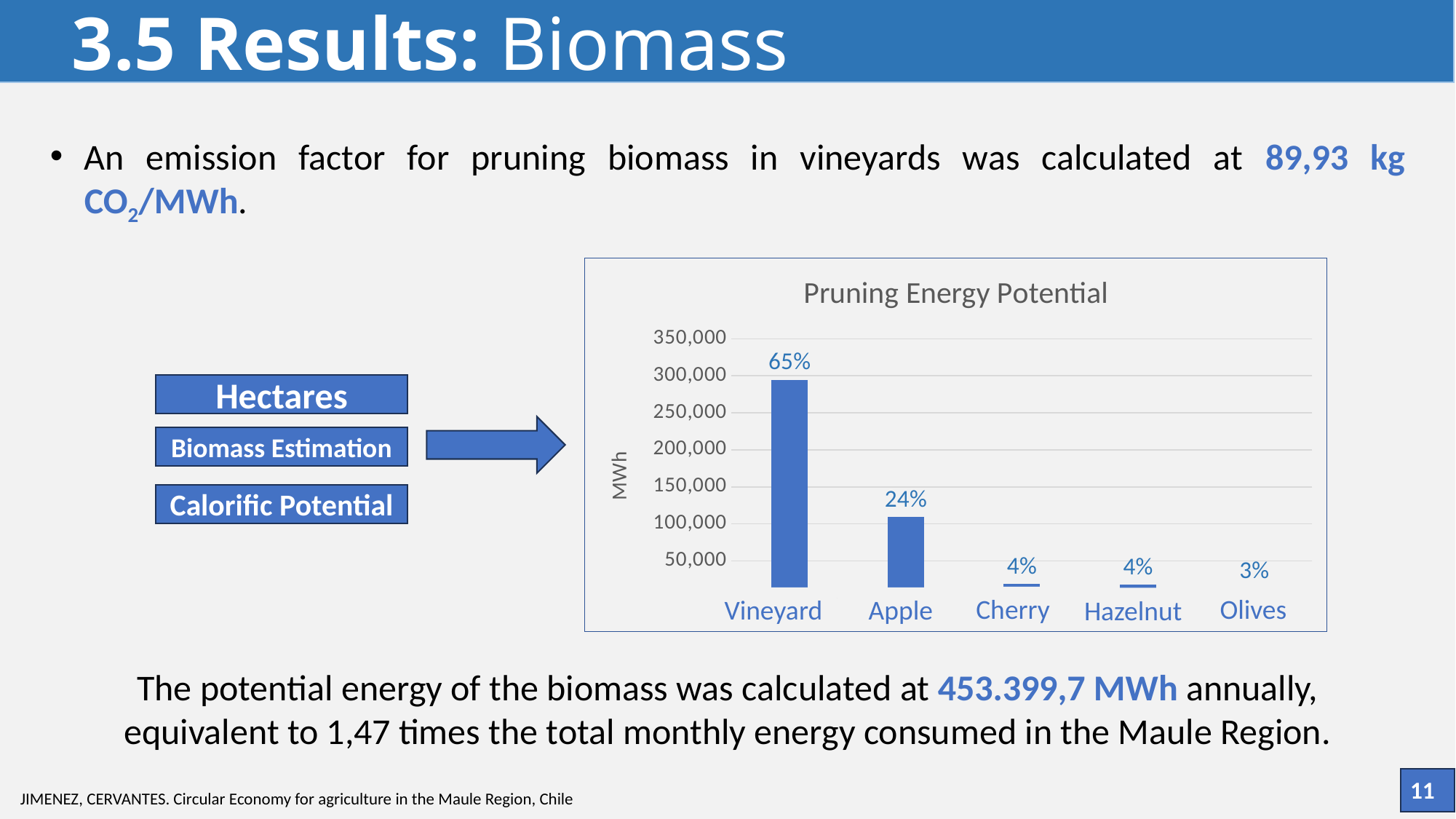
What type of chart is shown on the slide? bar chart Is the value for Vineyard greater or less than 250,000 MWh? greater What percentage label is shown for Vineyard? 65% Which category has the highest pruning energy potential? Vineyard What is the title of the chart? Pruning Energy Potential What percentage label is shown for Olives? 3% What percentage label is shown for Apple? 24% Do the values rise or fall from left to right along the x axis? fall What is the difference between the percentage labels for Vineyard and Apple? 41 percentage points How many categories are shown on the x axis? 5 Which has a larger pruning energy potential, Apple or Cherry? Apple Which category has the lowest pruning energy potential? Olives